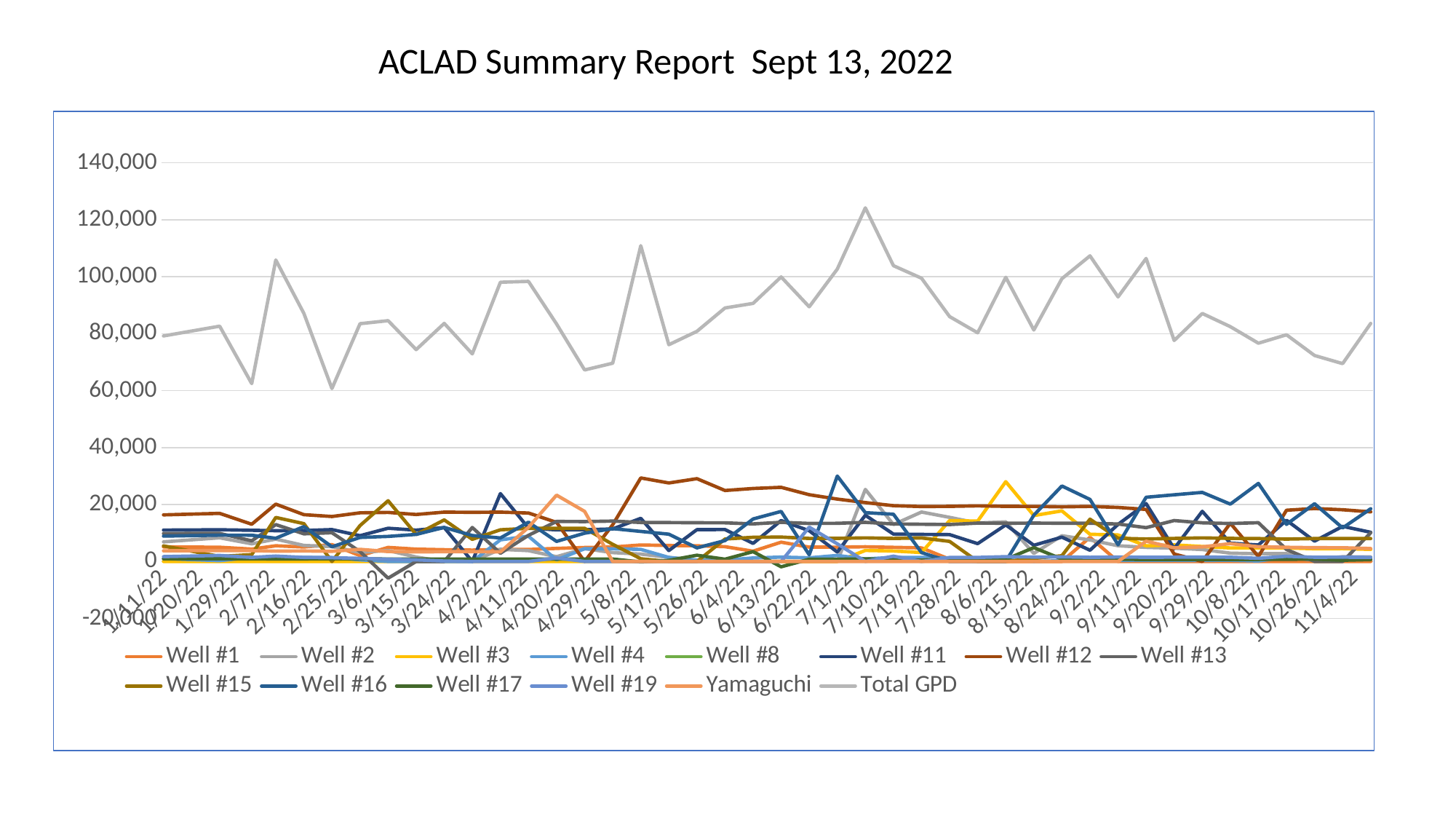
Is the lowest value of the Total GPD series greater or less than 40,000? greater What kind of chart is shown on the slide? Line chart Which series is larger at every date, Total GPD or Well #12? Total GPD Is the highest value reached by the Total GPD series greater or less than 120,000? greater What is the last date label on the horizontal axis? 11/4/22 What is the highest value shown on the vertical axis? 140,000 What is the title of the slide? ACLAD Summary Report Sept 13, 2022 Is the highest value reached by Well #12 greater or less than 20,000? greater What is the first date label on the horizontal axis? 1/11/22 How many series does the chart legend list? 14 Which series has the highest values throughout the chart? Total GPD